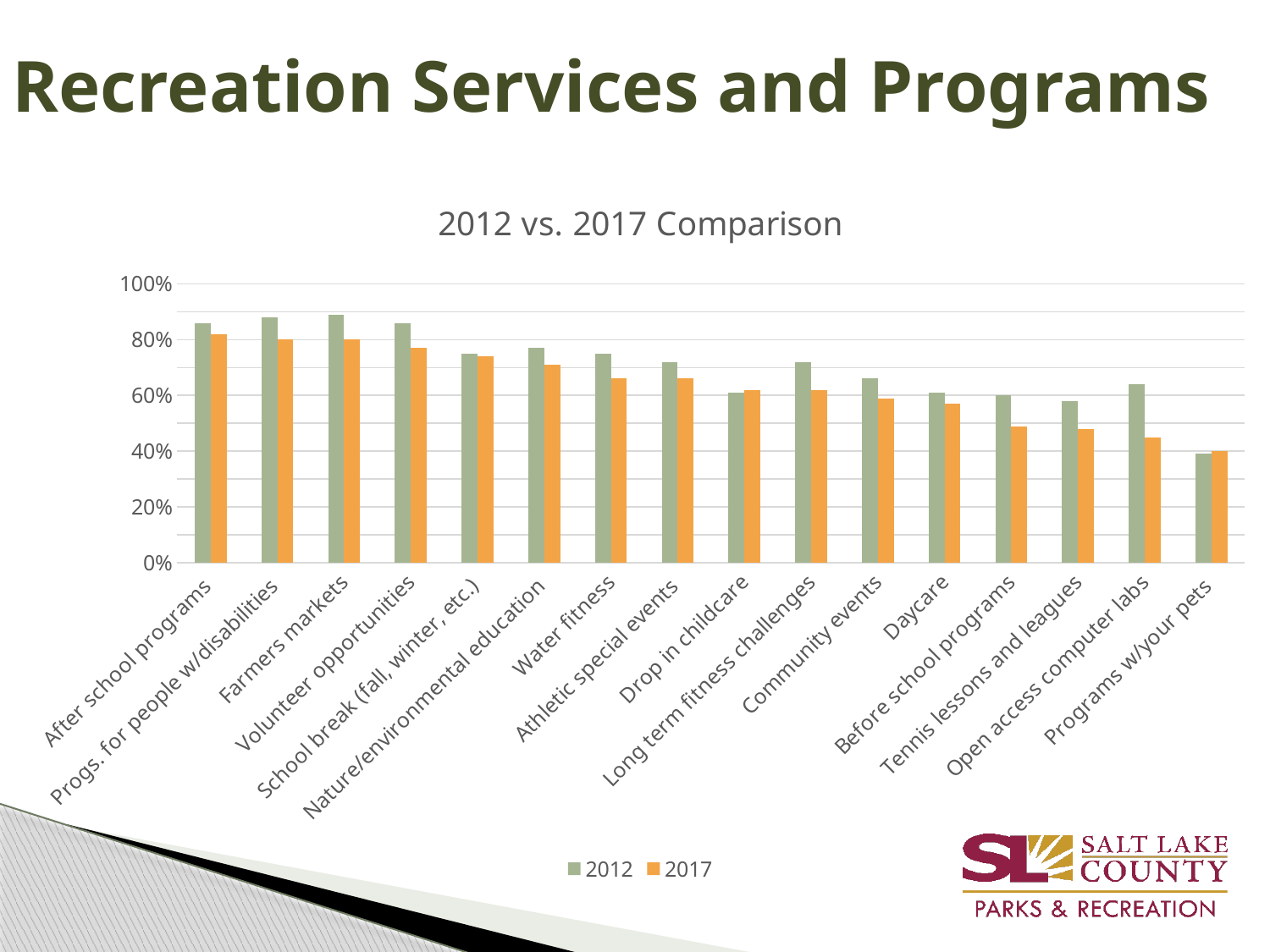
Which category has the lowest 2012 value? Programs w/your pets How many categories are shown on the x axis? 16 Is the 2017 value for Open access computer labs greater or less than 60%? less How many series does the legend list? 2 Is the 2012 value for Long term fitness challenges greater or less than 60%? greater What is the title of the chart? 2012 vs. 2017 Comparison Which series is shown in orange? 2017 Do the 2012 values generally rise or fall moving from left to right along the x axis? fall Is the 2017 value for Before school programs greater or less than 60%? less For Open access computer labs, which is larger, the 2012 value or the 2017 value? 2012 What kind of chart is shown on the slide? Bar chart